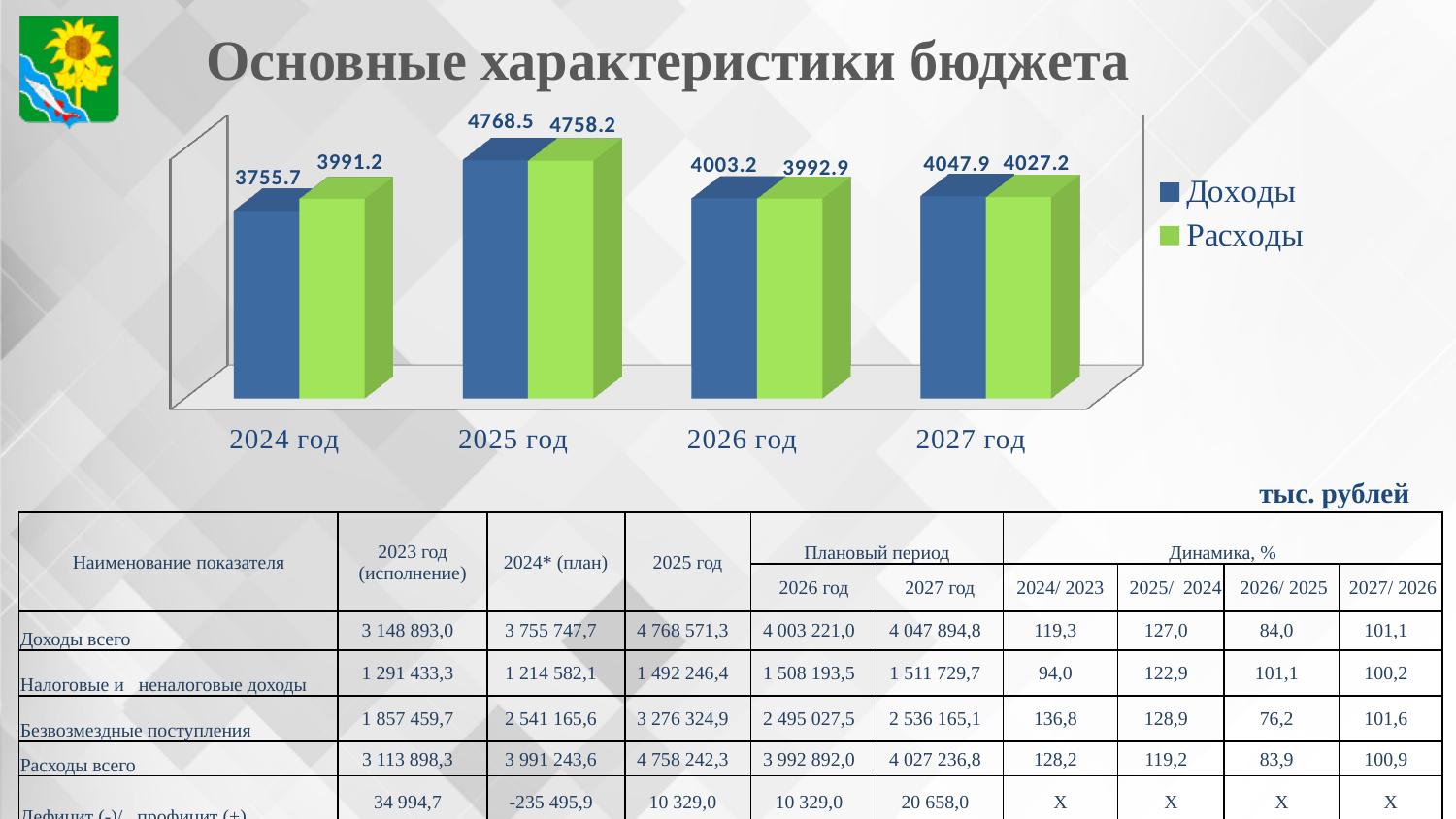
How many years are shown on the x axis of the chart? 4 In which year is Расходы the lowest? 2024 год How many series does the chart legend list? 2 What is the value of Расходы for 2027 год? 4027.2 For 2024 год, which is larger: Доходы or Расходы? Расходы What is the value of Расходы for 2024 год? 3991.2 What kind of chart is shown on the slide? bar chart In which year is Доходы the highest? 2025 год What is the value of Доходы for 2025 год? 4768.5 Does Доходы rise or fall from 2025 год to 2026 год? fall What is the difference between Расходы and Доходы for 2024 год? 235.5 What is the difference between Доходы and Расходы for 2027 год? 20.7